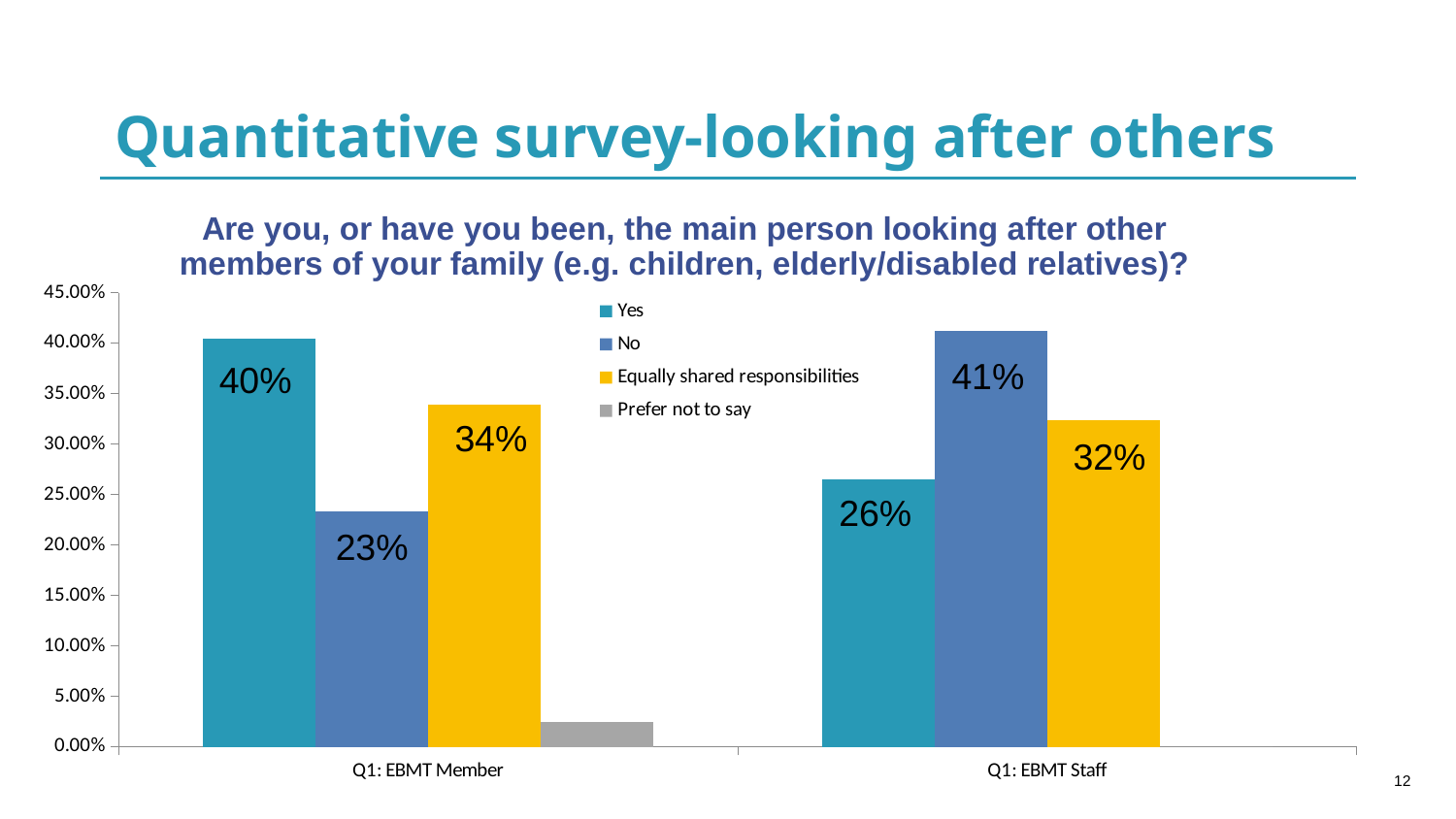
What percentage of EBMT Staff answered No? 41% Which is larger: the No value for EBMT Member or the No value for EBMT Staff? EBMT Staff What is the difference between the Yes and No values for EBMT Members? 17% What is the value for Equally shared responsibilities among EBMT Members? 34% Is the Prefer not to say value for EBMT Member greater or less than 5.00%? less Which response has the highest value for EBMT Staff? No Which colour represents the Equally shared responsibilities series? yellow What is the value for Yes among EBMT Staff? 26% Which response has the lowest value for EBMT Member? Prefer not to say How many series does the legend list? 4 What kind of chart is shown on the slide? bar chart What percentage of EBMT Members answered Yes? 40%